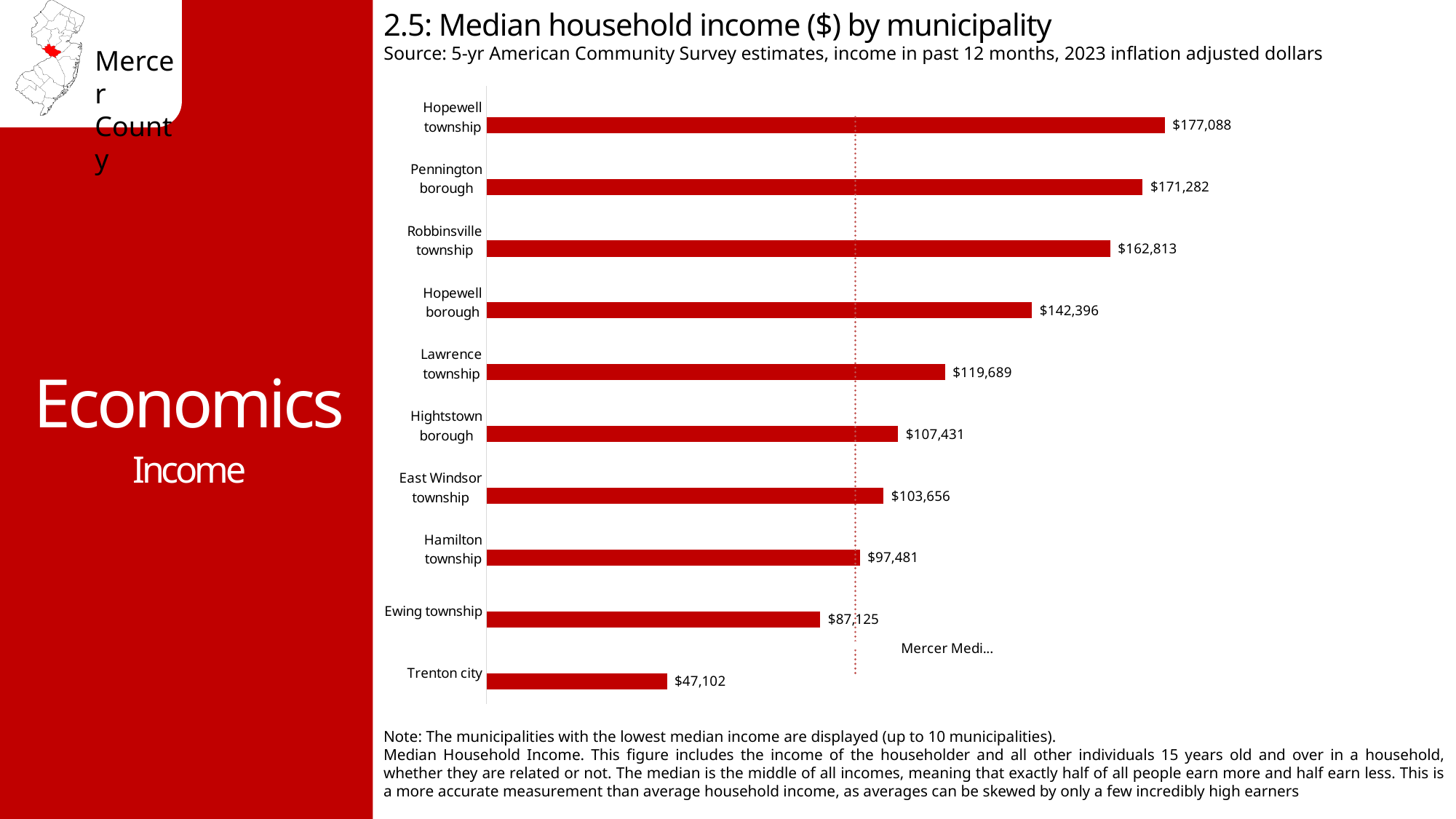
Which municipality has the lowest median household income? Trenton city What is the difference in median household income between Hamilton township and Trenton city? $50,379 What is the difference in median household income between Hopewell township and Pennington borough? $5,806 What is the median household income for Lawrence township? $119,689 Which municipality has the highest median household income? Hopewell township Which has a higher median household income, Hightstown borough or East Windsor township? Hightstown borough How many municipalities are shown in the chart? 10 What is the median household income for Trenton city? $47,102 What is the median household income for Hopewell township? $177,088 What kind of chart is used to show median household income by municipality? Bar chart What is the title of the chart? 2.5: Median household income ($) by municipality What is the median household income for Ewing township? $87,125